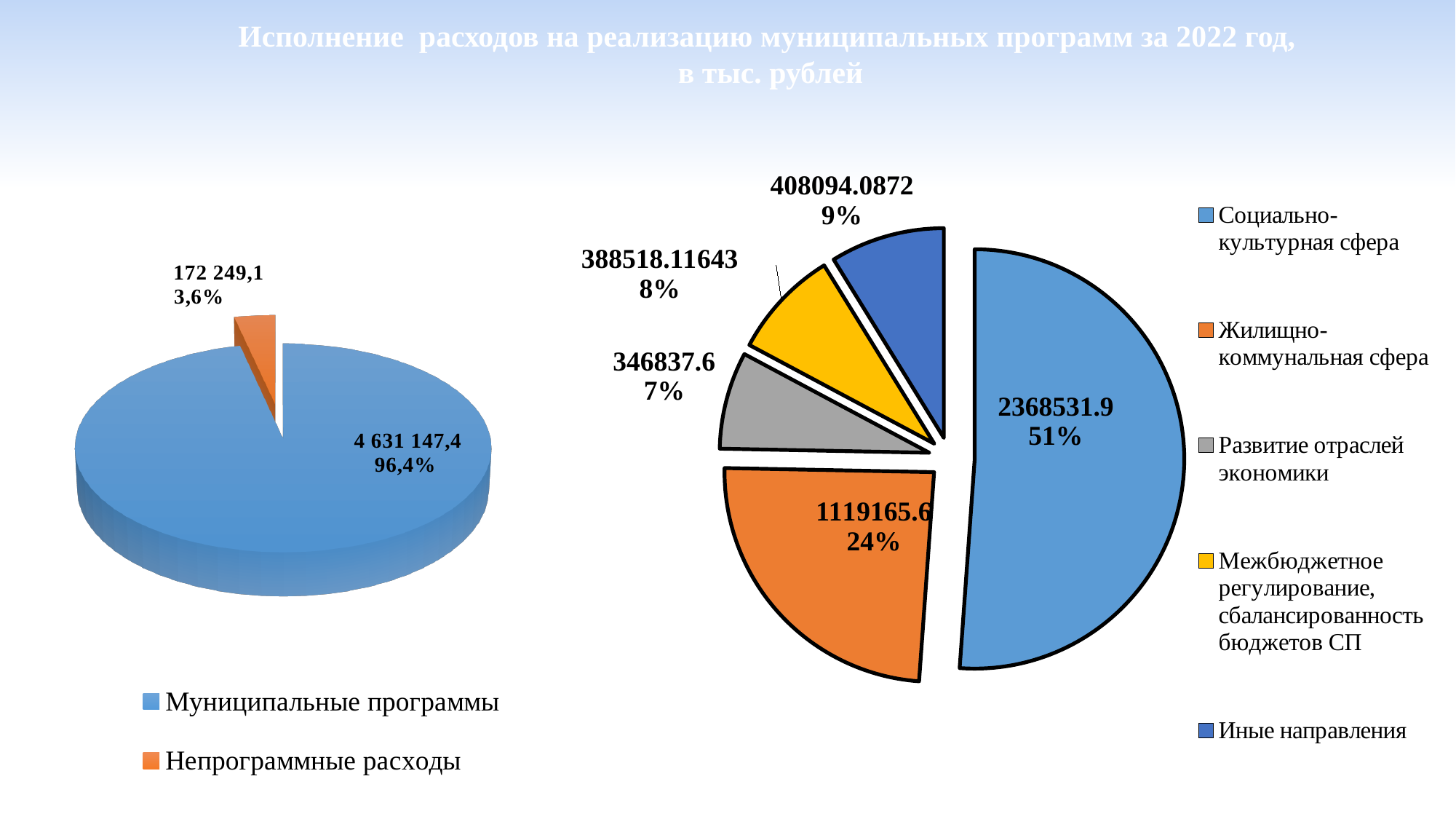
On the right pie chart, what value is shown for Иные направления? 408094.0872 What type of chart is the left chart? Pie chart On the left pie chart, what share of the pie does Непрограммные расходы take? 3,6% On the left pie chart, what value is shown for Муниципальные программы? 4 631 147,4 On the left pie chart, what value is shown for Непрограммные расходы? 172 249,1 On the right pie chart, which category has the largest slice? Социально-культурная сфера On the right pie chart, which is larger: Межбюджетное регулирование, сбалансированность бюджетов СП or Иные направления? Иные направления On the right pie chart, what value is shown for Развитие отраслей экономики? 346837.6 On the right pie chart, which category has the smallest slice? Развитие отраслей экономики How many categories does the legend of the right pie chart list? 5 On the right pie chart, what value is shown for Социально-культурная сфера? 2368531.9 On the right pie chart, what share of the pie does Жилищно-коммунальная сфера take? 24%